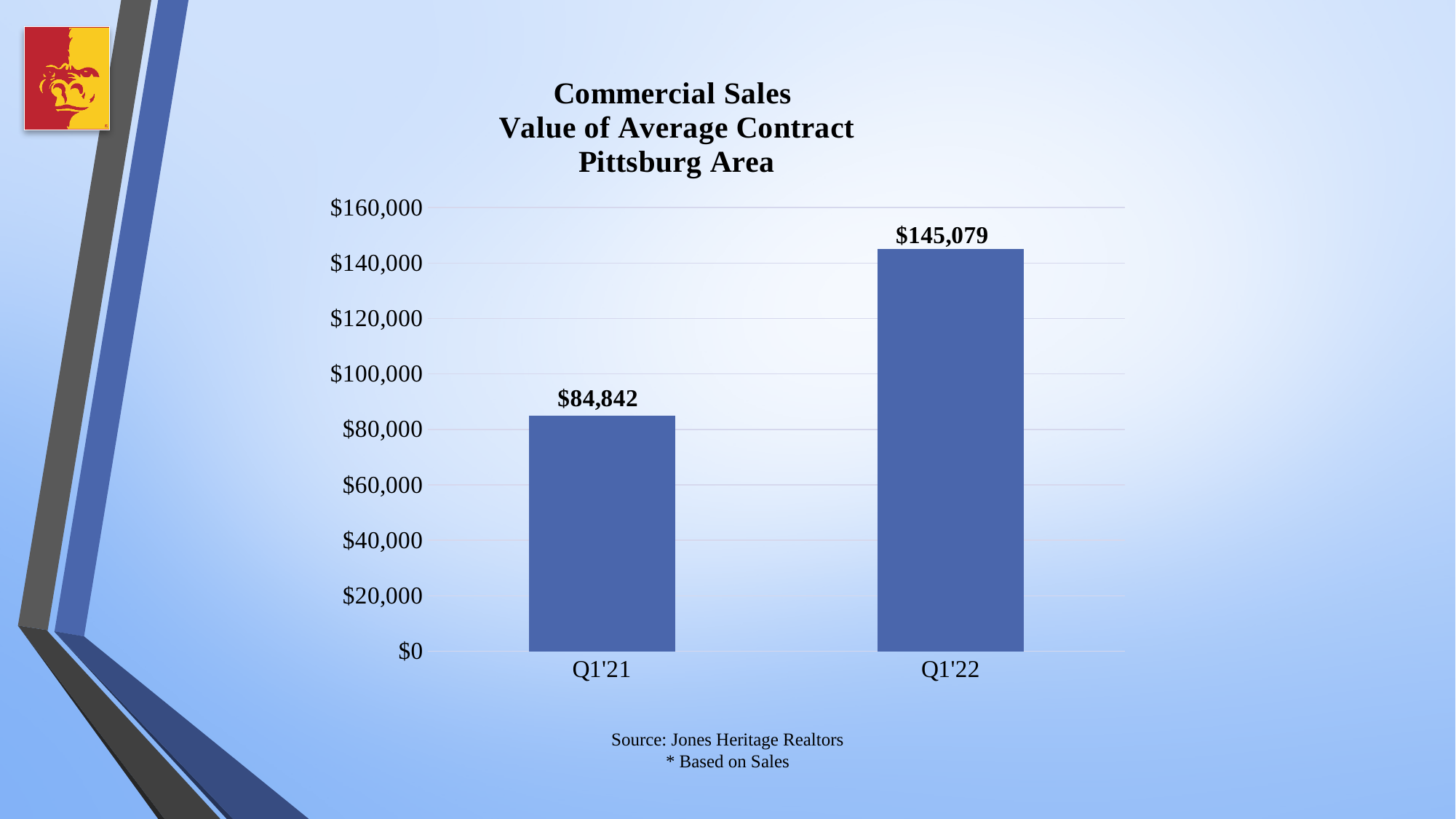
What is the difference between the Q1'22 and Q1'21 average contract values? $60,237 Which quarter has the lower average contract value? Q1'21 Is the average contract value larger in Q1'21 or Q1'22? Q1'22 Is the value for Q1'22 greater or less than $140,000? greater Which quarter has the higher average contract value? Q1'22 Does the average contract value rise or fall from Q1'21 to Q1'22? Rise How many quarters are shown on the chart? 2 What kind of chart is shown on the slide? Bar chart What is the source cited for the chart data? Jones Heritage Realtors What is the value of the average commercial contract for Q1'22? $145,079 Is the value for Q1'21 greater or less than $100,000? less What is the value of the average commercial contract for Q1'21? $84,842